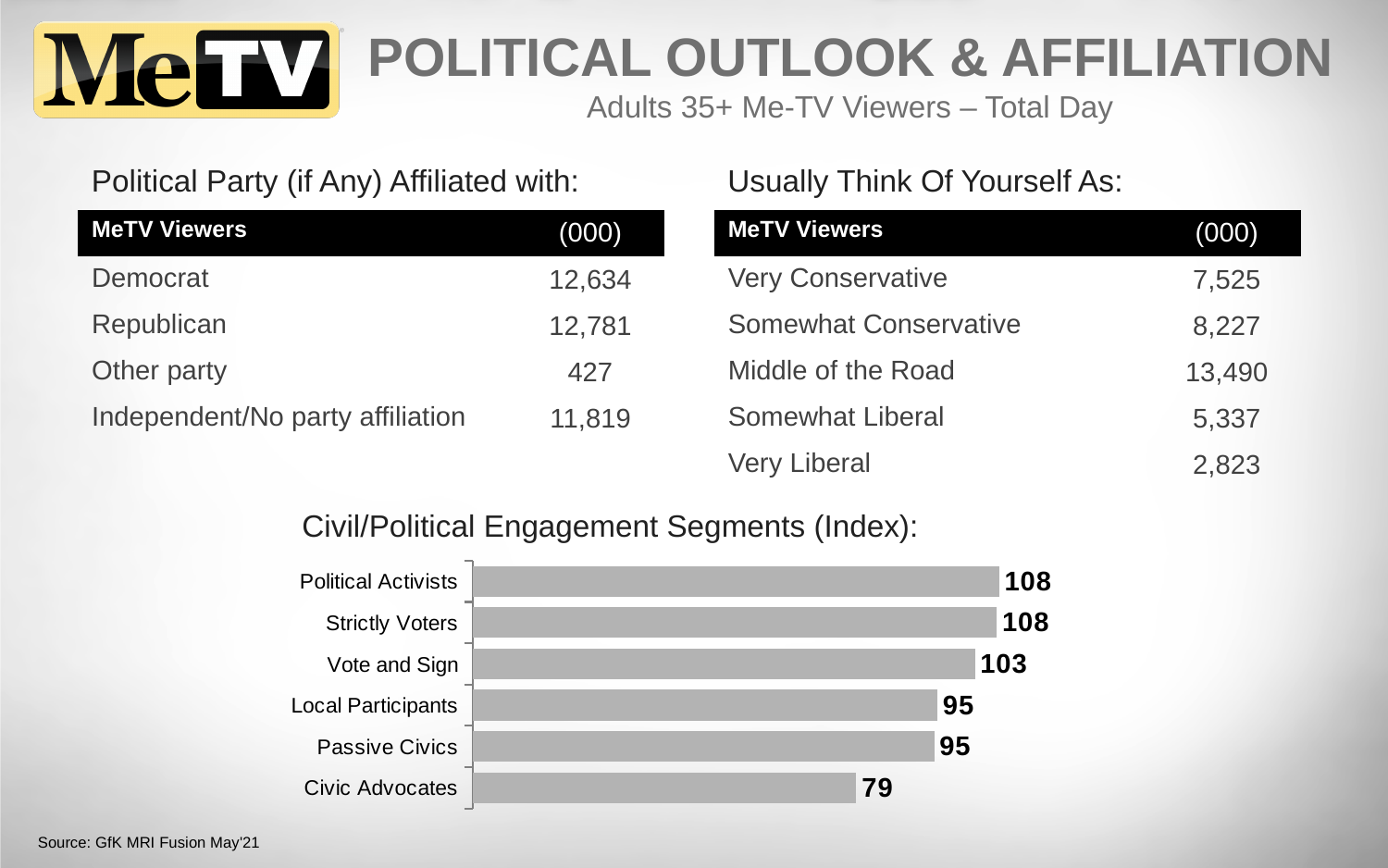
What is the title of the chart on the slide? Civil/Political Engagement Segments (Index): In the Civil/Political Engagement Segments chart, what is the difference between the index for Vote and Sign and the index for Passive Civics? 8 What is the index value for Strictly Voters in the Civil/Political Engagement Segments chart? 108 In the Civil/Political Engagement Segments chart, what is the difference between the index for Political Activists and the index for Civic Advocates? 29 What is the index value for Vote and Sign in the Civil/Political Engagement Segments chart? 103 In the Civil/Political Engagement Segments chart, which has a higher index: Vote and Sign or Local Participants? Vote and Sign What is the index value for Local Participants in the Civil/Political Engagement Segments chart? 95 What is the highest index value shown in the Civil/Political Engagement Segments chart? 108 What type of chart is the Civil/Political Engagement Segments chart? Bar chart How many segments are shown in the Civil/Political Engagement Segments chart? 6 What is the index value for Civic Advocates in the Civil/Political Engagement Segments chart? 79 Which segment has the lowest index in the Civil/Political Engagement Segments chart? Civic Advocates